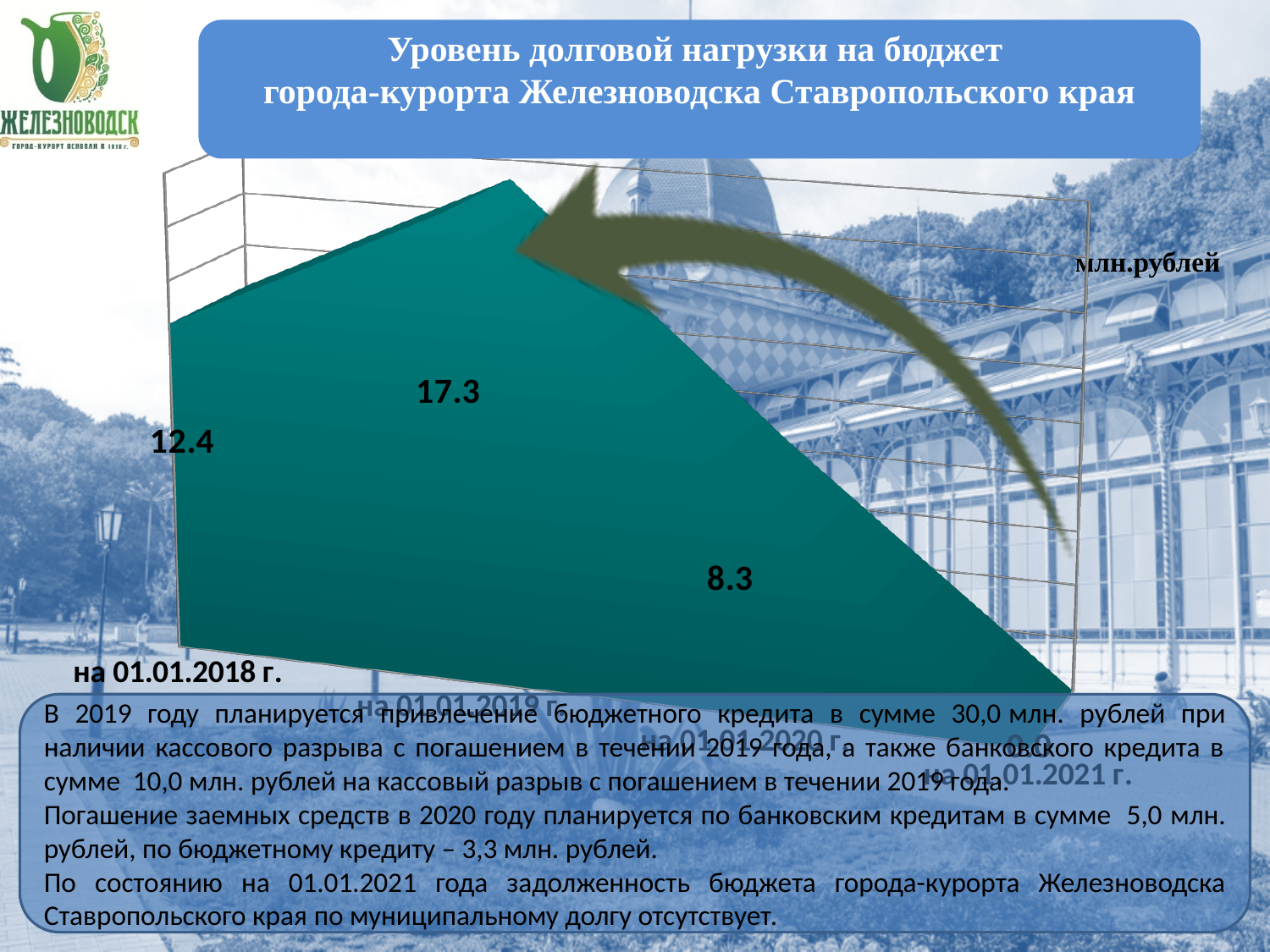
What is the debt load value on 01.01.2020? 8.3 What kind of chart is shown on the slide? area chart What is the debt load value on 01.01.2019? 17.3 On which date is the debt load highest? на 01.01.2019 г. Which is larger: the value on 01.01.2018 or on 01.01.2020? 01.01.2018 What is the difference between the values on 01.01.2019 and 01.01.2020? 9.0 What is the debt load value on 01.01.2018? 12.4 In what units are the chart values given? млн.рублей On which date is the debt load lowest? на 01.01.2021 г. How many dates are plotted on the chart? 4 How do the values change from 01.01.2018 to 01.01.2021? rise, then fall By how much does the value on 01.01.2019 exceed the value on 01.01.2018? 4.9